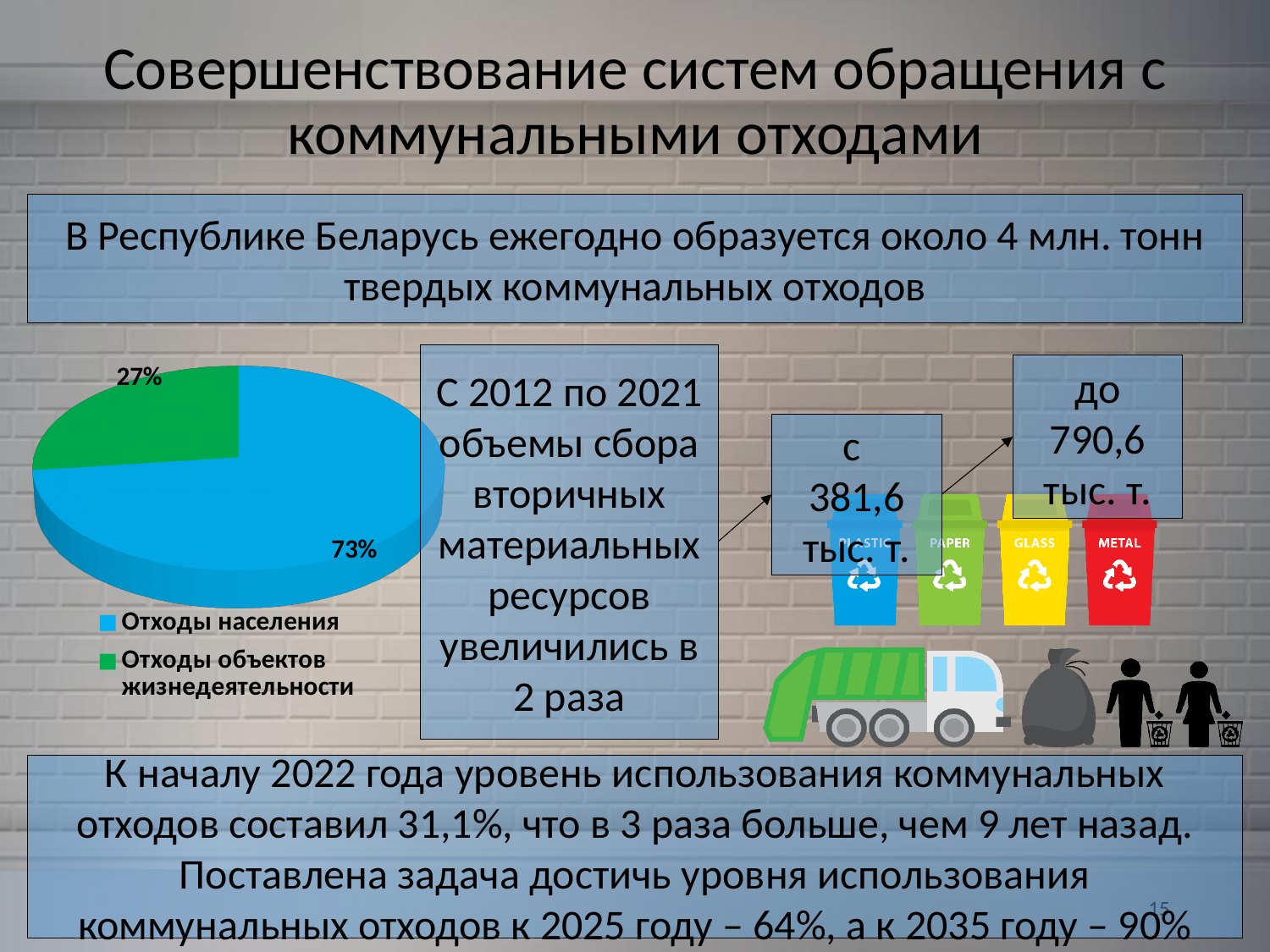
What share of the pie does "Отходы населения" have? 73% Which category has the largest slice of the pie? Отходы населения What colour is the slice for "Отходы населения"? blue What colour is the slice for "Отходы объектов жизнедеятельности"? green How many slices does the pie chart have? 2 What kind of chart is shown on the slide? pie chart Which category has the smallest slice of the pie? Отходы объектов жизнедеятельности What is the difference in percentage points between "Отходы населения" and "Отходы объектов жизнедеятельности"? 46 What share of the pie does "Отходы объектов жизнедеятельности" have? 27% Which is larger: the share for "Отходы населения" or for "Отходы объектов жизнедеятельности"? Отходы населения How many entries does the legend of the pie chart list? 2